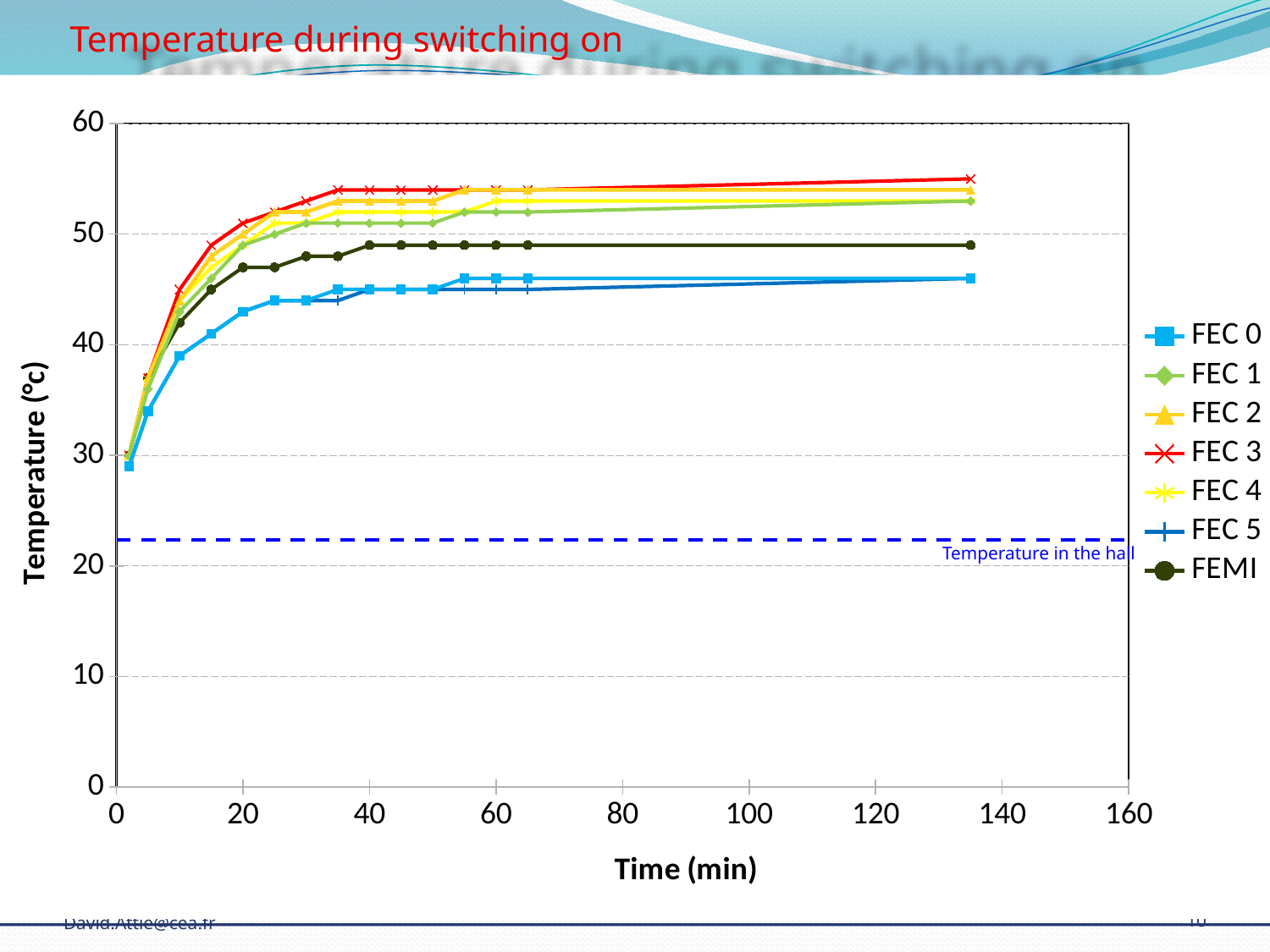
What is the title of the chart? Temperature during switching on Is the temperature of FEC 3 at 40 min greater or less than 50? greater At 40 min, which is higher: FEMI or FEC 0? FEMI At 135 min, which is higher: FEC 3 or FEC 0? FEC 3 What kind of chart is shown on the slide? Line chart Do the temperatures of the FEC series rise or fall as time increases? Rise Which series has the highest temperature at 135 min? FEC 3 What does the dashed blue horizontal line represent? Temperature in the hall Which series has the lowest temperature at 10 min? FEC 0 and FEC 5 (tied) Is the temperature in the hall (dashed line) greater or less than 30? less How many series does the legend list? 7 Is the temperature of FEC 0 at 135 min greater or less than 50? less